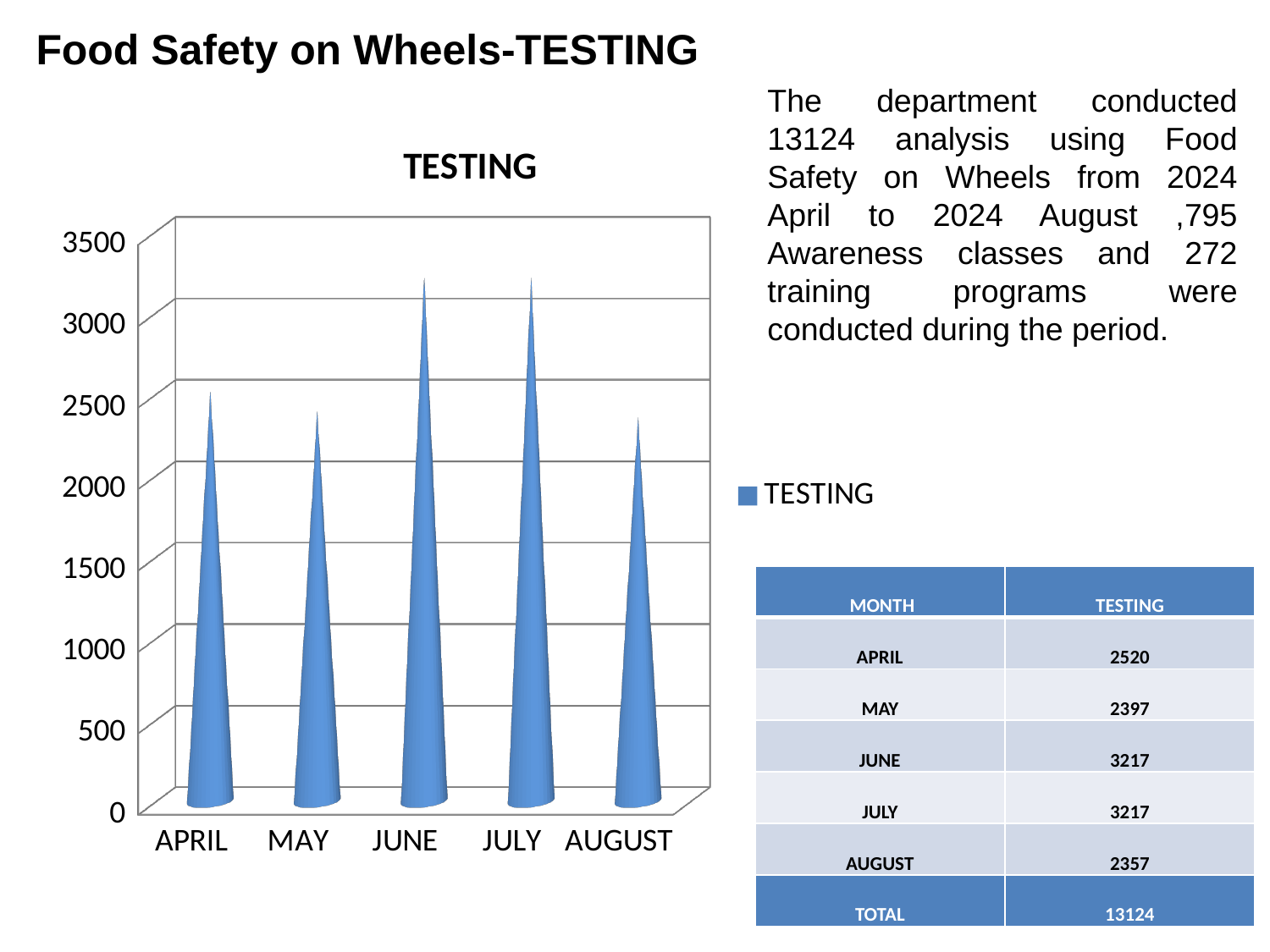
Is the TESTING value for MAY greater or less than 2500? less Which month has the lowest TESTING value? AUGUST What is the TESTING value for APRIL? 2520 What type of chart is shown on the slide? bar chart What is the TESTING value for AUGUST? 2357 What is the difference between the TESTING values for JUNE and MAY? 820 Which is larger, the TESTING value for JUNE or for APRIL? JUNE What is the title of the chart? TESTING How many series does the chart legend list? 1 How many months are plotted on the x axis of the chart? 5 Is the TESTING value for JULY greater or less than 3000? greater What is the TESTING value for JUNE? 3217